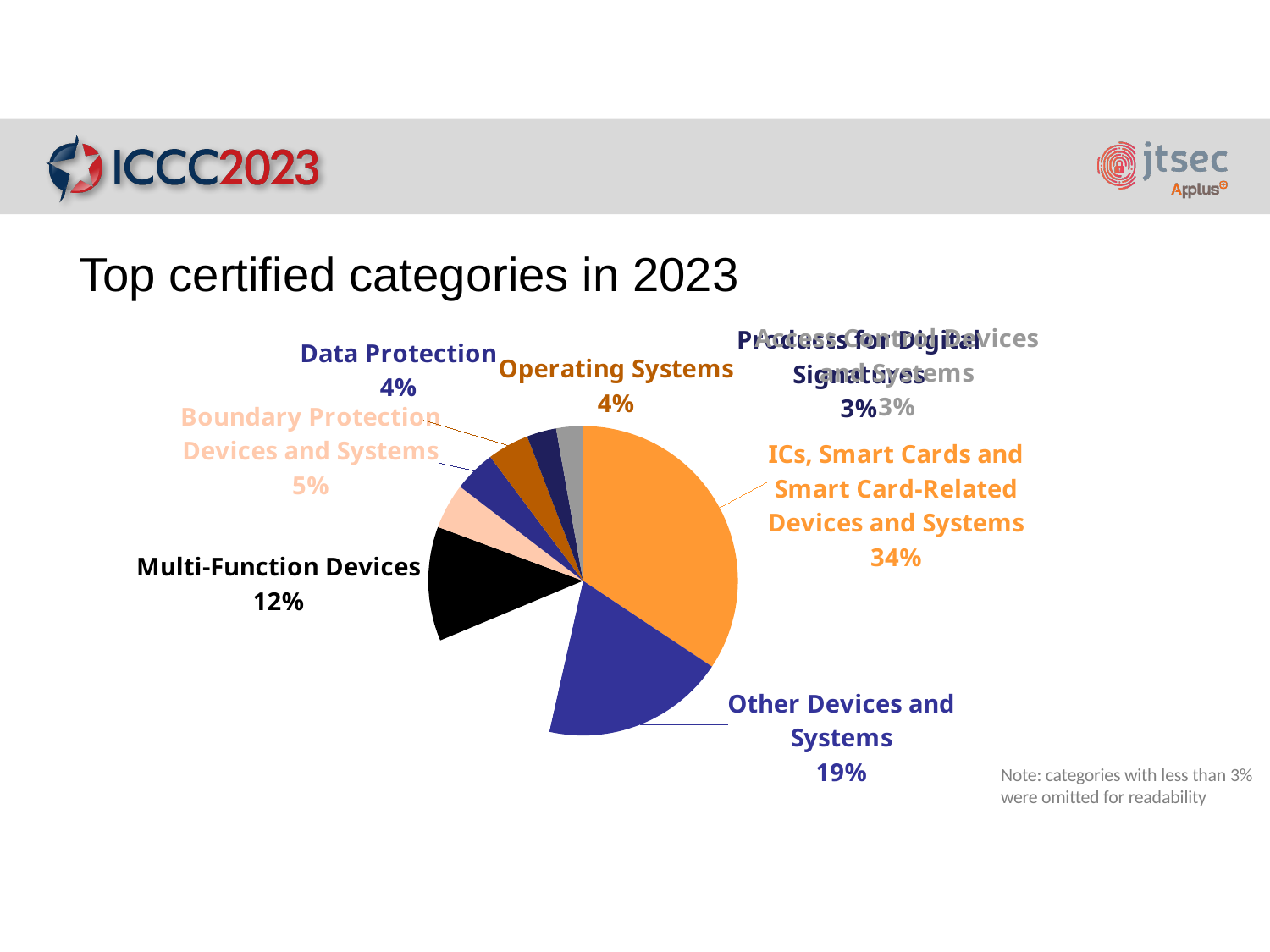
What percentage is shown for Data Protection? 4% What percentage is shown for Multi-Function Devices? 12% What is the title of the slide containing the chart? Top certified categories in 2023 What percentage is shown for Boundary Protection Devices and Systems? 5% Which is larger, the share for Multi-Function Devices or the share for Boundary Protection Devices and Systems? Multi-Function Devices According to the note on the slide, which categories were omitted from the chart? categories with less than 3% What percentage is shown for Operating Systems? 4% What share of the pie does ICs, Smart Cards and Smart Card-Related Devices and Systems hold? 34% What percentage is shown for Other Devices and Systems? 19% What kind of chart is shown on the slide? pie chart Which category has the largest slice of the pie? ICs, Smart Cards and Smart Card-Related Devices and Systems What is the difference in percentage points between ICs, Smart Cards and Smart Card-Related Devices and Systems and Other Devices and Systems? 15